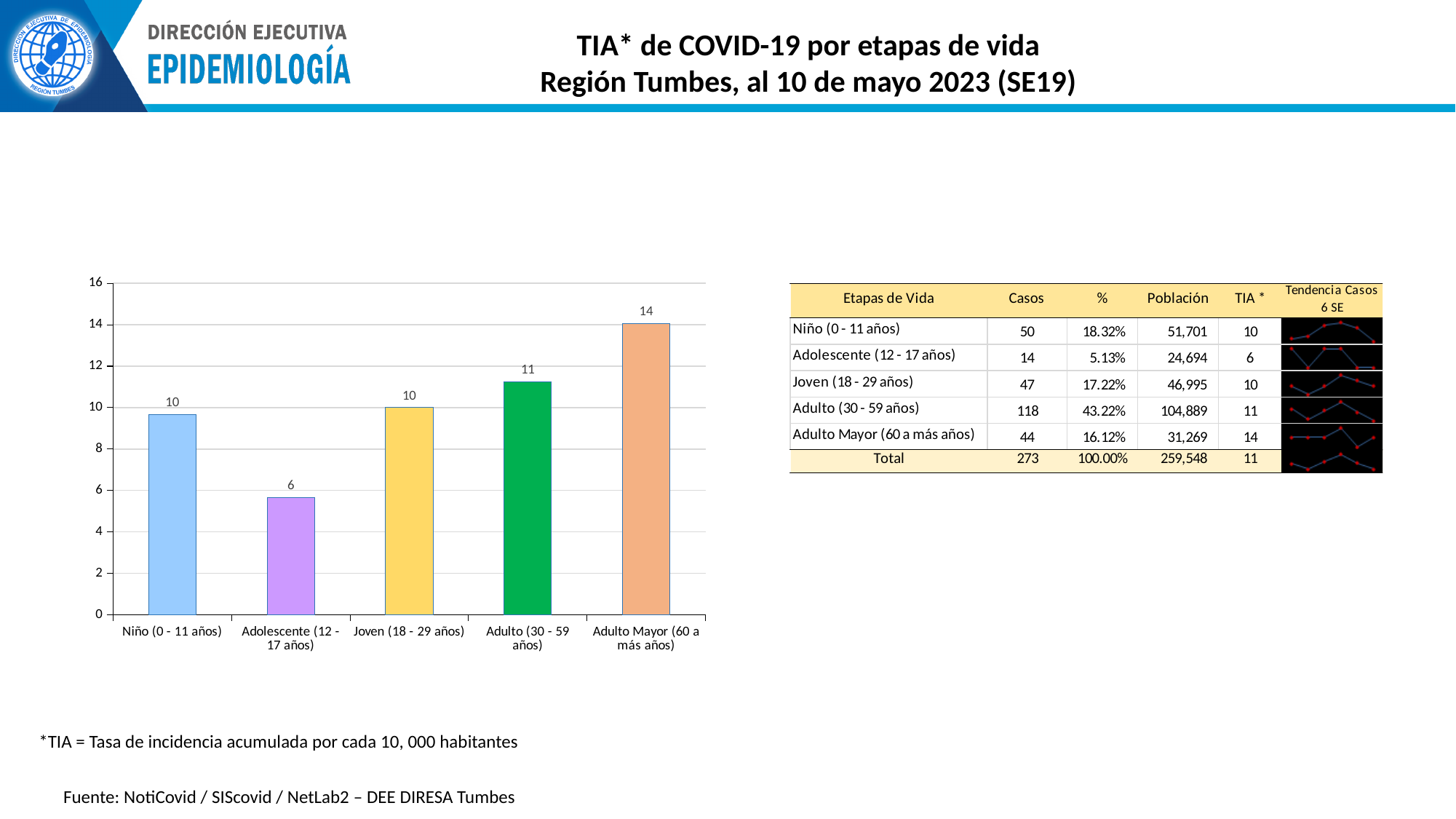
What kind of chart is used to show TIA by life stage on the slide? Bar chart In the bar chart, which has a higher TIA: Adulto (30 - 59 años) or Adolescente (12 - 17 años)? Adulto (30 - 59 años) What is the TIA value shown for Adolescente (12 - 17 años) in the bar chart? 6 Is the value for Adulto Mayor (60 a más años) in the bar chart greater or less than 12? greater Which life stage has the lowest TIA in the bar chart? Adolescente (12 - 17 años) What is the TIA value shown for Adulto Mayor (60 a más años) in the bar chart? 14 How many life-stage categories are shown in the bar chart? 5 What is the difference between the TIA for Adulto Mayor (60 a más años) and Adulto (30 - 59 años) in the bar chart? 3 What is the difference between the TIA for Adulto Mayor (60 a más años) and Adolescente (12 - 17 años) in the bar chart? 8 Which life stage has the highest TIA in the bar chart? Adulto Mayor (60 a más años) What is the TIA value shown for Adulto (30 - 59 años) in the bar chart? 11 What colour is the bar for Adulto (30 - 59 años) in the bar chart? Green